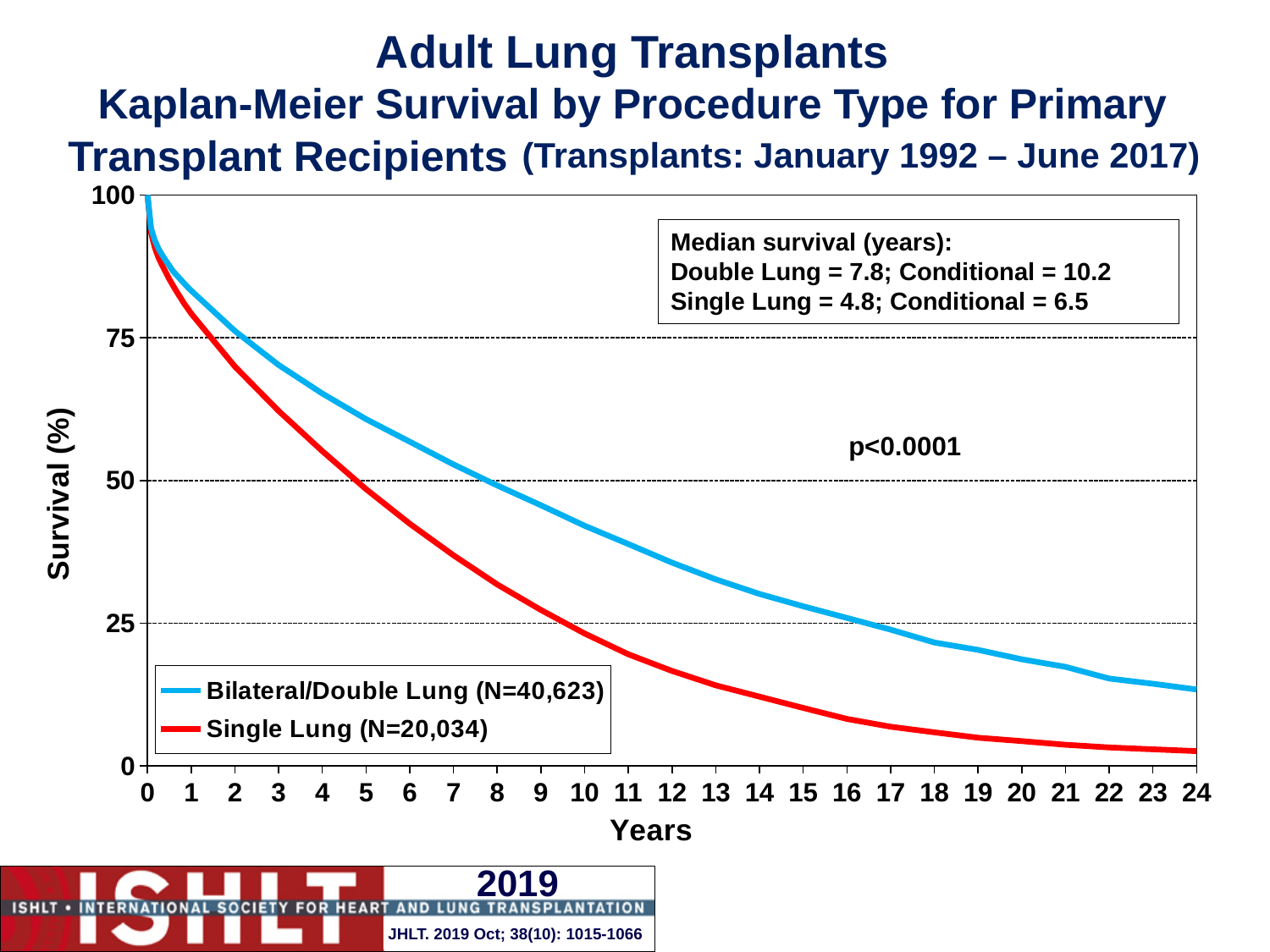
What is the conditional median survival in years for Double Lung recipients? 10.2 Is the survival for Single Lung at year 12 greater or less than 25? less Do the survival curves rise or fall as years increase along the x axis? Fall What is the number of Single Lung recipients (N) shown in the legend? 20,034 What is the median survival in years for Double Lung recipients, as stated in the text box? 7.8 Is the survival for Bilateral/Double Lung at year 5 greater or less than 50? greater What is the difference between the conditional median survival and the median survival for Single Lung recipients (6.5 vs 4.8)? 1.7 Which series has the higher survival at year 10, Bilateral/Double Lung or Single Lung? Bilateral/Double Lung What are the two series named in the legend? Bilateral/Double Lung (N=40,623) and Single Lung (N=20,034) How many series does the legend list? 2 What is the median survival in years for Single Lung recipients, as stated in the text box? 4.8 What kind of chart is shown on the slide? Line chart